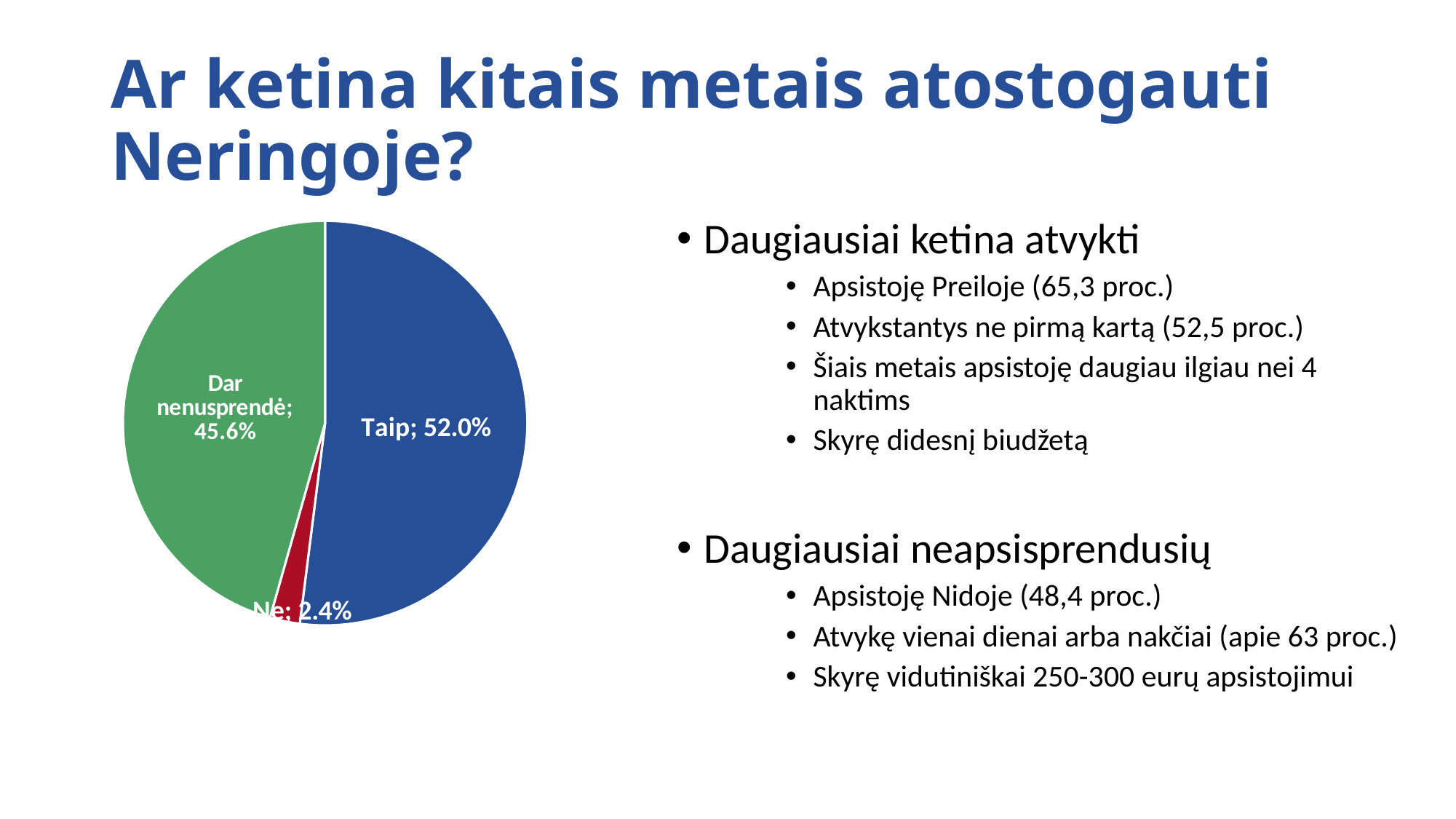
What share of the pie does the "Ne" slice represent? 2.4% What share of the pie does the "Dar nenusprendė" slice represent? 45.6% What is the difference in percentage points between the "Dar nenusprendė" and "Ne" slices? 43.2 Which slice of the pie is the smallest? Ne Which slice of the pie is the largest? Taip What colour is the "Taip" slice of the pie? blue What kind of chart is shown on the slide? pie chart Which is larger, the "Dar nenusprendė" slice or the "Ne" slice? Dar nenusprendė What share of the pie does the "Taip" slice represent? 52.0% What is the difference in percentage points between the "Taip" and "Dar nenusprendė" slices? 6.4 What colour is the "Ne" slice of the pie? red How many slices does the pie chart have? 3